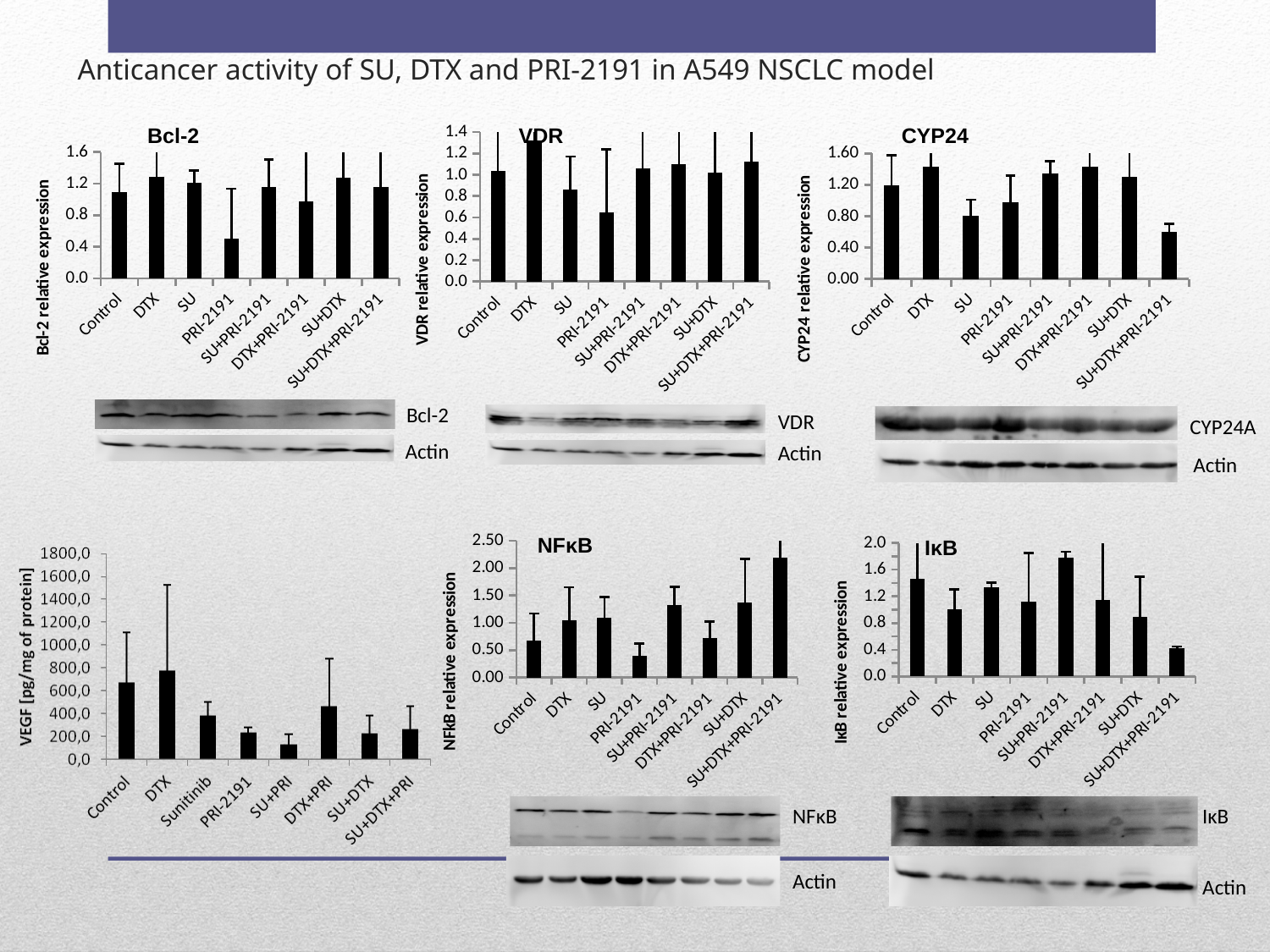
In the VDR chart, which category has the highest value? DTX How many categories are shown on the x axis of the NFκB chart? 8 In the VEGF chart (bottom left), is the value for DTX greater or less than 600,0? greater In the CYP24 chart, which category has the lowest value? SU+DTX+PRI-2191 What kind of chart is the VEGF chart (bottom left)? bar chart In the Bcl-2 chart, which category has the lowest value? PRI-2191 In the Bcl-2 chart, is the value for PRI-2191 greater or less than 0.8? less In the VDR chart, is the value for DTX greater or less than 1.2? greater In the NFκB chart, which category has the highest value? SU+DTX+PRI-2191 In the VEGF chart (bottom left), which category has the lowest value? SU+PRI In the IκB chart, which category has the highest value? SU+PRI-2191